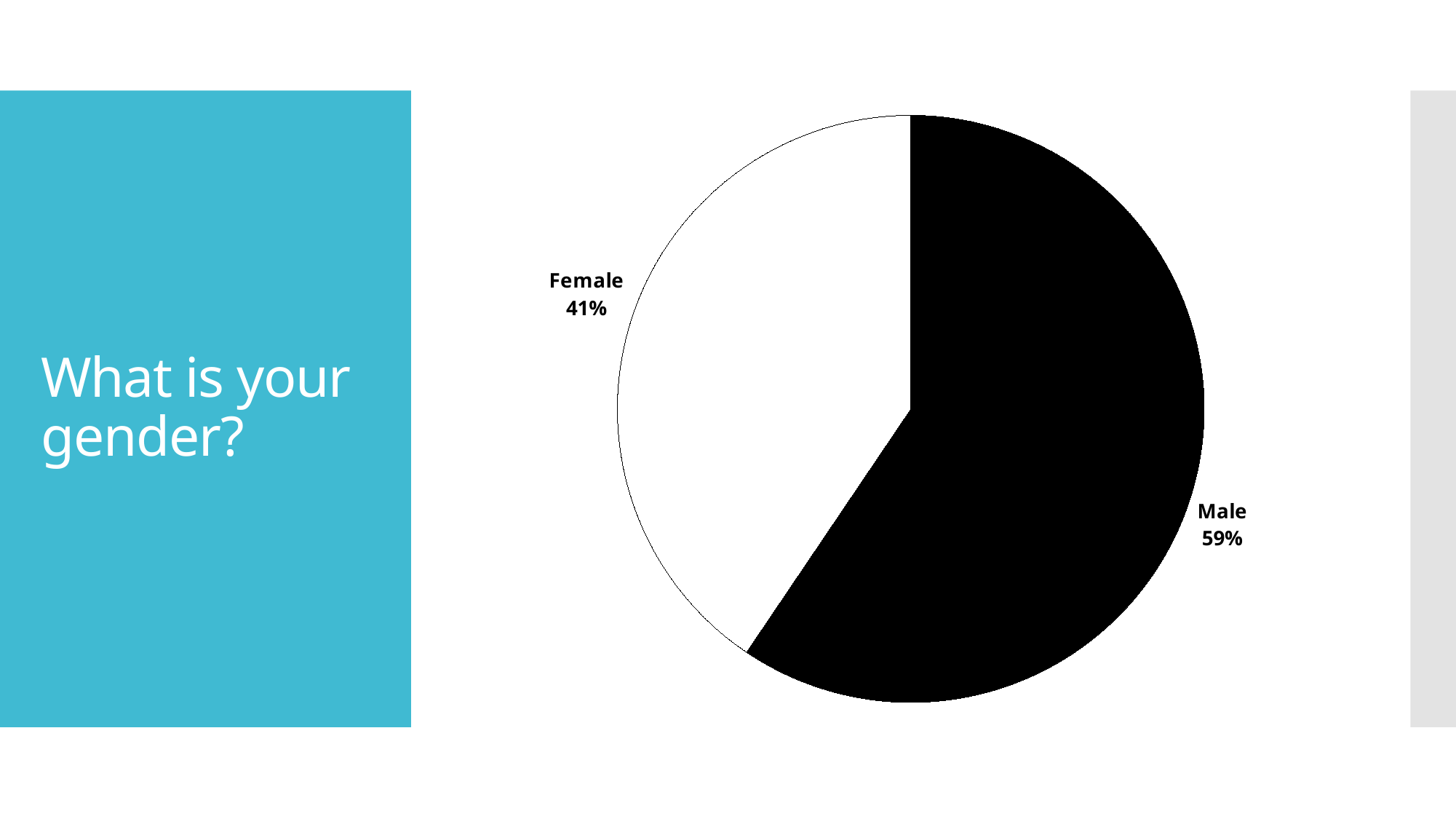
What question does the slide title ask? What is your gender? What share of the pie does the Female slice represent? 41% What kind of chart is shown on the slide? Pie chart What percentage of respondents are Female? 41% How many slices does the pie chart have? 2 What colour is the Male slice of the pie chart? Black Which is larger, the Male share or the Female share? Male Which gender has the largest share of the pie? Male Which gender has the smallest share of the pie? Female What is the difference in percentage points between the Male and Female shares? 18 What percentage of respondents are Male? 59% What is the total of the two slices shown in the pie chart? 100%